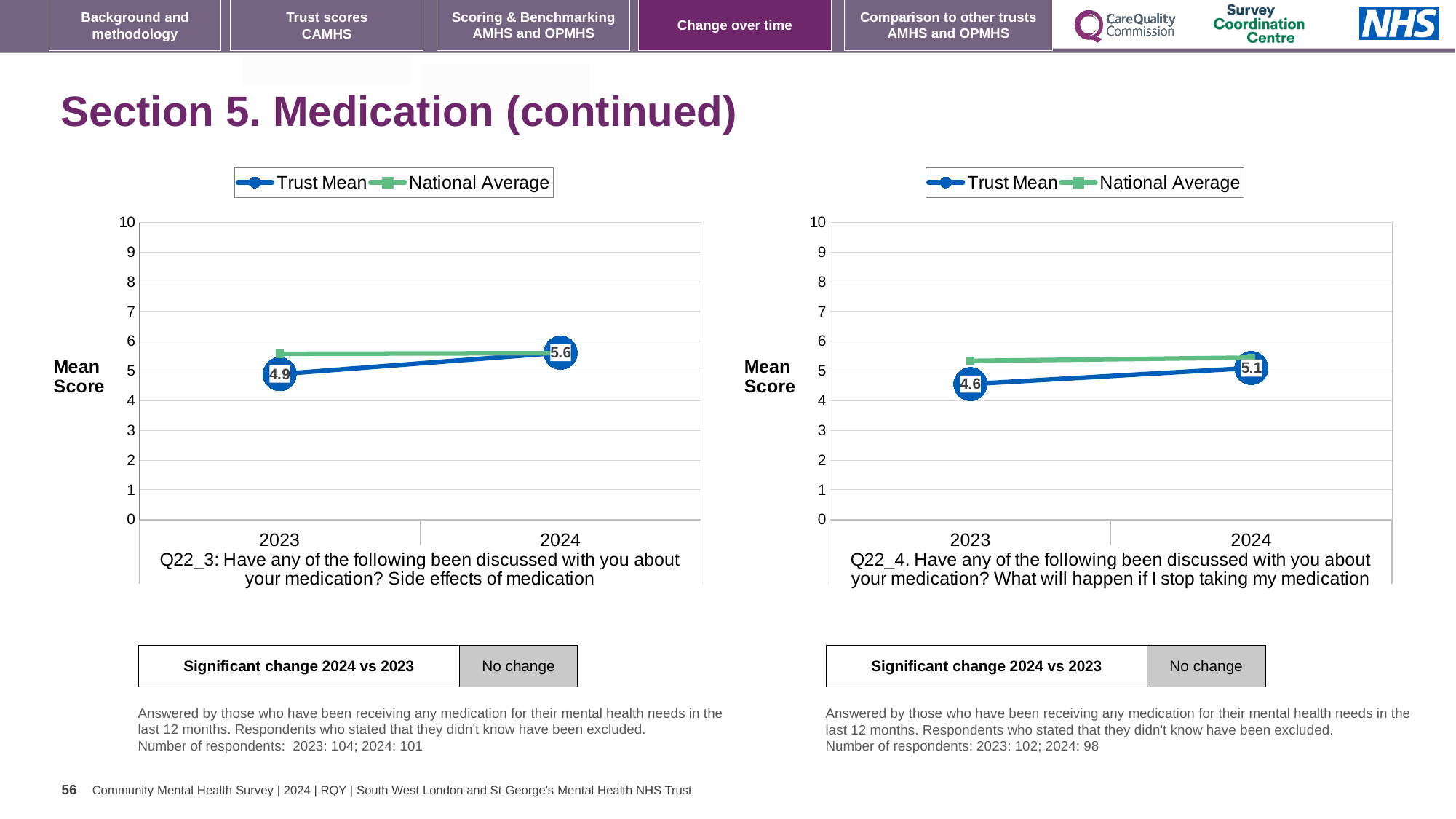
In the left chart (Q22_3), what is the Trust Mean score for 2024? 5.6 In the right chart (Q22_4), does the Trust Mean rise or fall from 2023 to 2024? rise In the right chart (Q22_4), which is larger for 2023: the Trust Mean or the National Average? National Average In the left chart (Q22_3), is the National Average for 2023 greater or less than 5? greater What kind of chart is the left chart (Q22_3)? line chart In the right chart (Q22_4), by how much did the Trust Mean change from 2023 to 2024? 0.5 How many years are plotted on the x axis of the left chart (Q22_3)? 2 In the left chart (Q22_3), by how much did the Trust Mean change from 2023 to 2024? 0.7 In the right chart (Q22_4), what is the Trust Mean score for 2023? 4.6 How many series does the legend of the right chart (Q22_4) list? 2 In the left chart (Q22_3), what is the Trust Mean score for 2023? 4.9 In the right chart (Q22_4), what is the Trust Mean score for 2024? 5.1